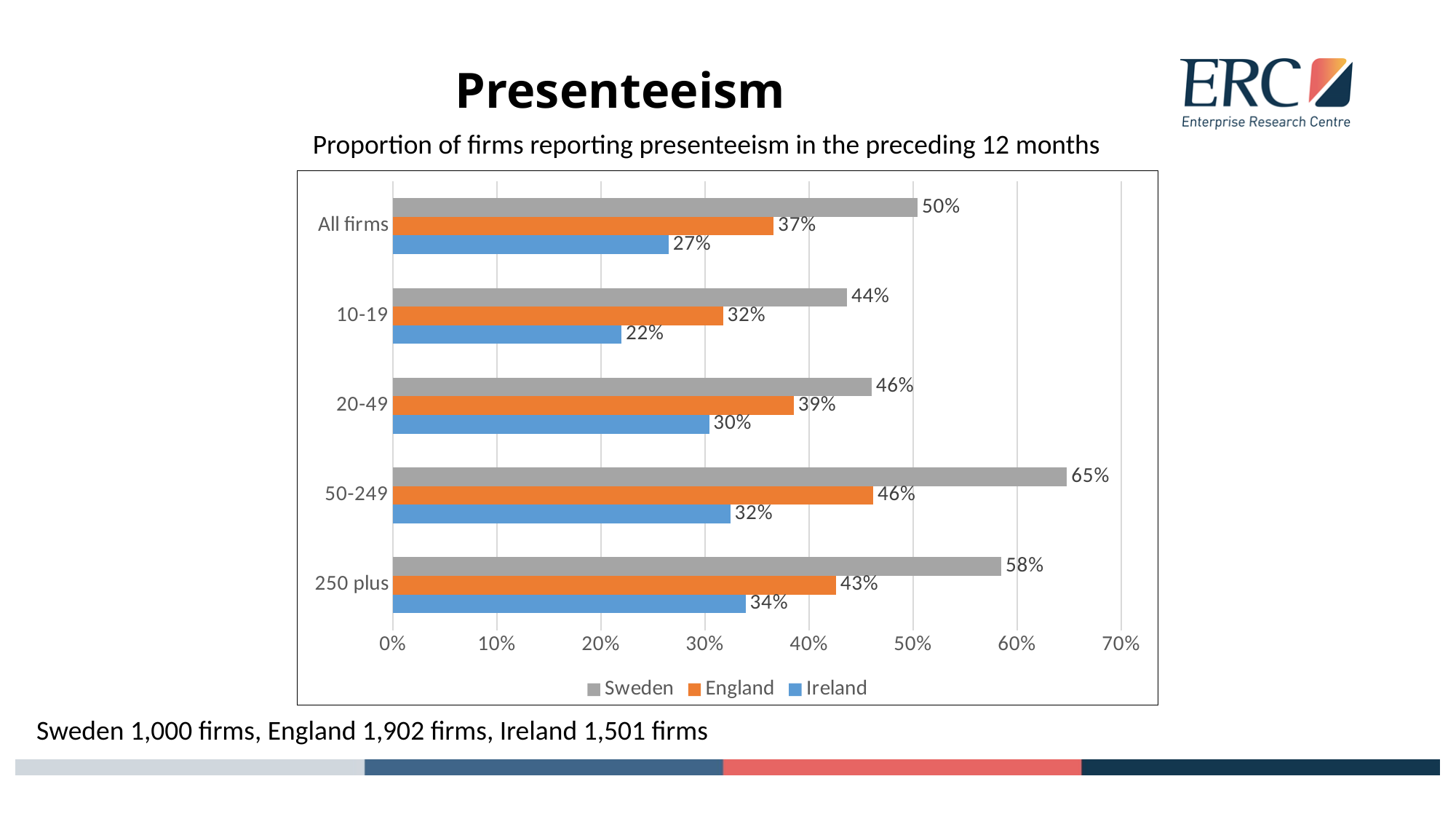
Which firm size category has the highest value for Sweden? 50-249 How many series does the legend list? 3 Which firm size category has the lowest value for Ireland? 10-19 What is the difference between the Sweden and Ireland values in the 250 plus category? 24% What is the value for England for All firms? 37% How many firm size categories are shown on the chart? 5 Which is larger in the 20-49 category: the value for England or the value for Ireland? England What is the value for Sweden in the 50-249 category? 65% Is the value for Sweden in the 50-249 category greater or less than 60%? greater What kind of chart is shown on the slide? Bar chart What is the value for Ireland in the 10-19 category? 22% Which colour represents England in the chart? Orange